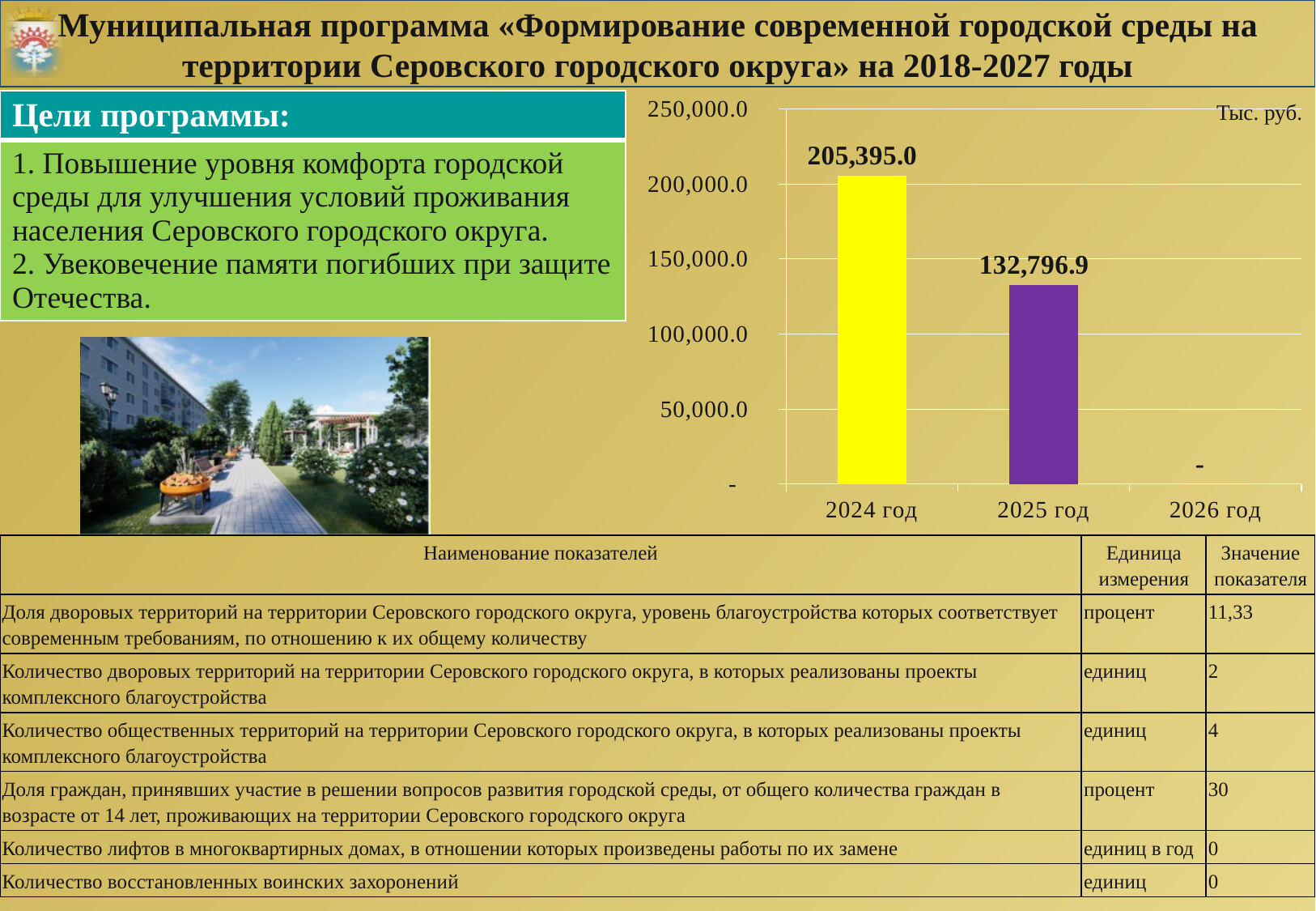
Which year has the highest value in the chart? 2024 год Which of the two years with bars, 2024 год or 2025 год, has the larger value? 2024 год Do the values fall or rise from 2024 год to 2025 год? fall What type of chart is shown on the slide? bar chart What colour is the bar for 2025 год? purple How many year categories are shown on the x axis of the chart? 3 Is the value for 2024 год greater or less than 200,000.0? greater What is the value for 2024 год in the chart? 205,395.0 Is the value for 2025 год greater or less than 150,000.0? less What unit of measurement is indicated in the top right corner of the chart? Тыс. руб. What is the difference between the values for 2024 год and 2025 год? 72,598.1 What is the value for 2025 год in the chart? 132,796.9